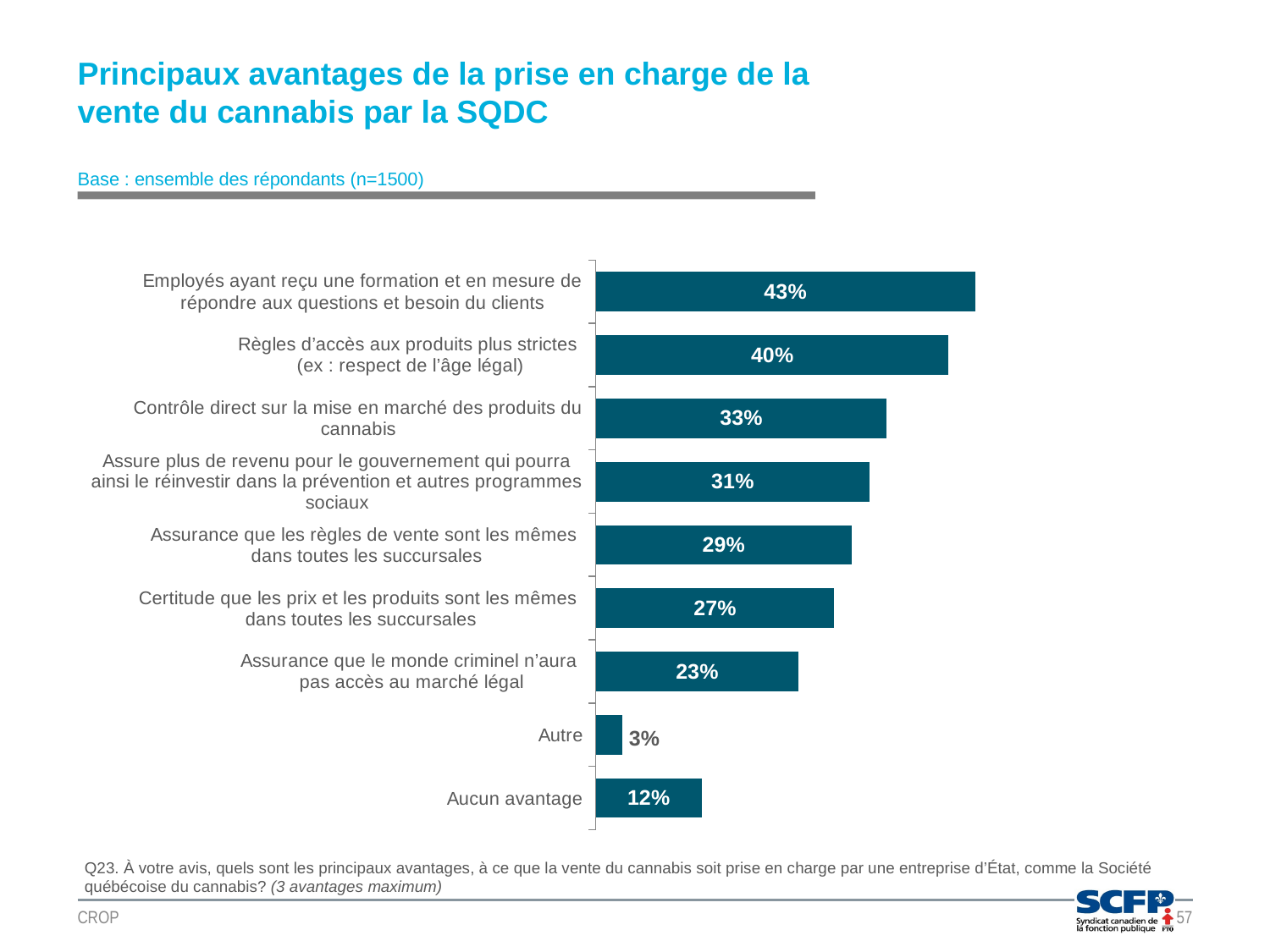
What is the value shown for "Aucun avantage"? 12% Which category has the lowest value in the chart? Autre What is the difference between the values for "Règles d'accès aux produits plus strictes" and "Contrôle direct sur la mise en marché des produits du cannabis"? 7 percentage points What percentage of respondents cited "Employés ayant reçu une formation et en mesure de répondre aux questions et besoin du clients" as an advantage? 43% How many categories are shown in the chart? 9 Which is larger: the value for "Assurance que les règles de vente sont les mêmes dans toutes les succursales" or the value for "Certitude que les prix et les produits sont les mêmes dans toutes les succursales"? Assurance que les règles de vente sont les mêmes dans toutes les succursales What is the value shown for "Assurance que le monde criminel n'aura pas accès au marché légal"? 23% What is the difference between the values for "Aucun avantage" and "Autre"? 9 percentage points What is the value shown for "Assure plus de revenu pour le gouvernement qui pourra ainsi le réinvestir dans la prévention et autres programmes sociaux"? 31% Which category has the highest value in the chart? Employés ayant reçu une formation et en mesure de répondre aux questions et besoin du clients What is the base (number of respondents) stated on the slide? n=1500 What kind of chart is shown on the slide? Bar chart